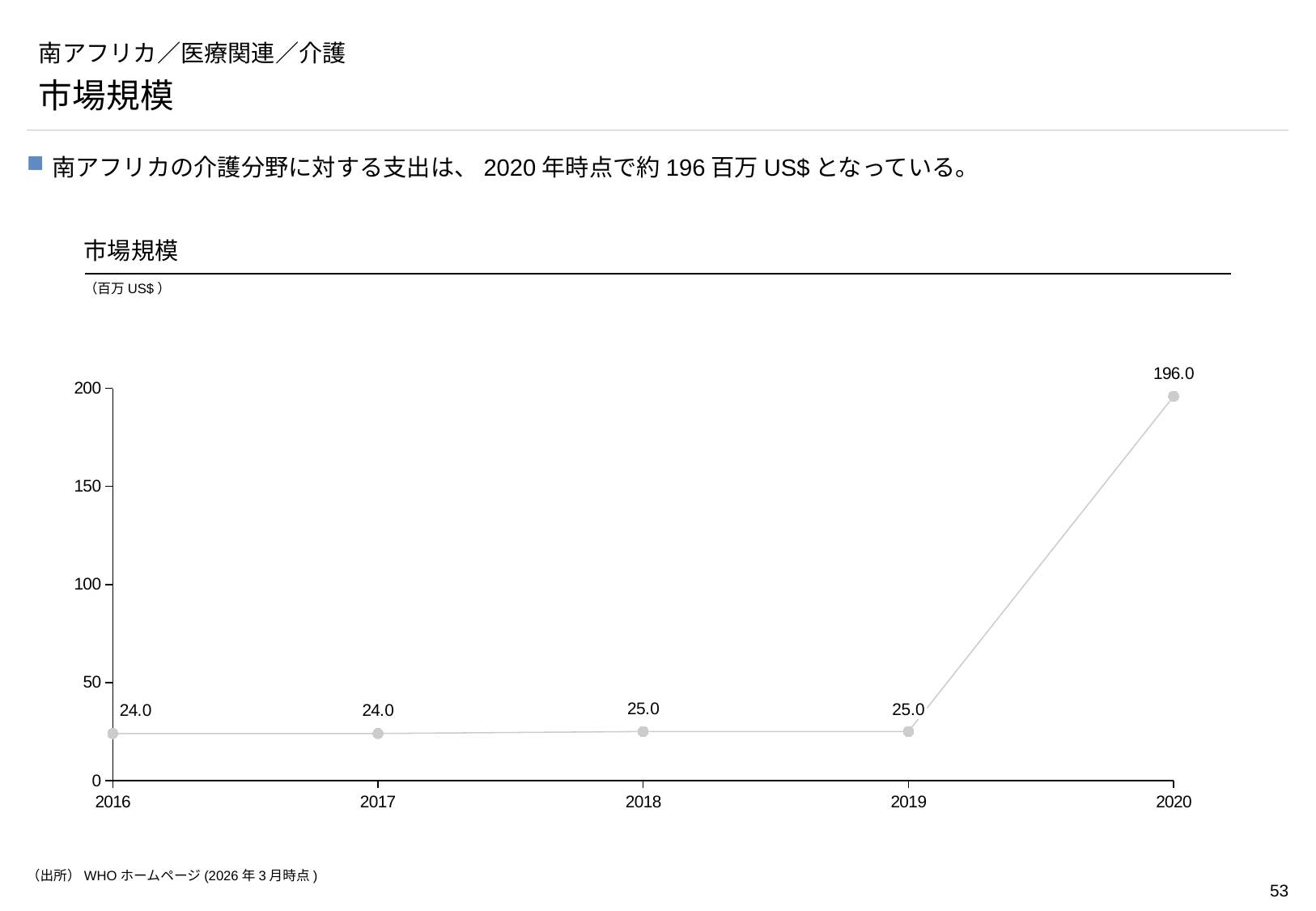
What unit is shown for the chart's values? 百万 US$ How many years are plotted on the chart? 5 What kind of chart is shown? line chart Is the value for 2017 greater or less than 50? less Which year has the highest value? 2020 Is the value for 2020 greater or less than 150? greater What is the value for 2016? 24.0 What is the difference between the values for 2020 and 2019? 171.0 Which is larger, the value for 2020 or the value for 2016? 2020 What is the value for 2020? 196.0 What is the value for 2018? 25.0 What is the difference between the values for 2018 and 2017? 1.0